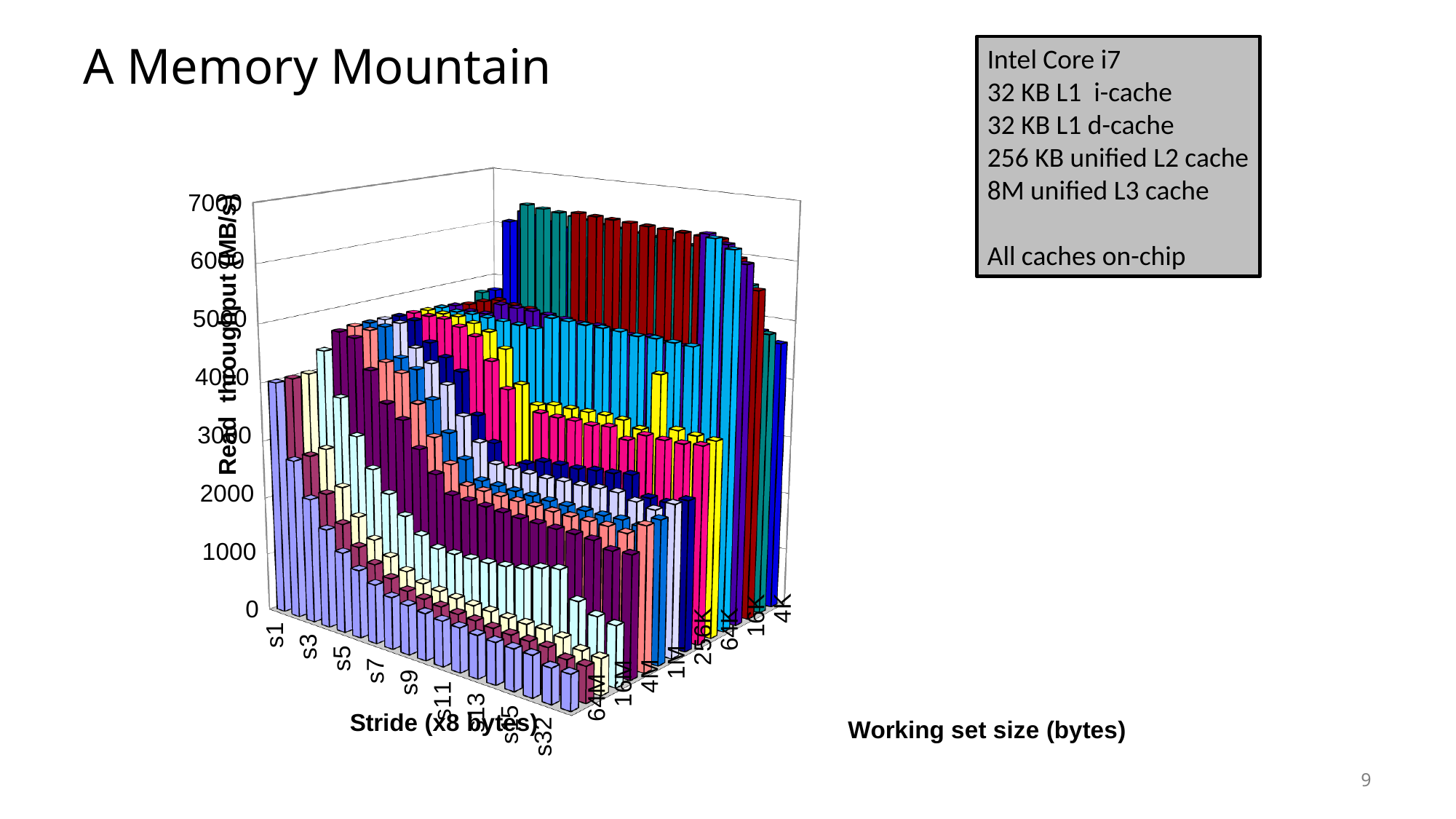
For the 64M working set size, is the read throughput at stride s32 greater or less than 2000? less What is the label of the stride axis of the chart? Stride (x8 bytes) For the 64M working set size, does read throughput rise or fall as the stride increases from s1 to s32? fall For the 64M working set size, which stride has the lowest read throughput? s32 For the 64M working set size, which stride has the highest read throughput? s1 What kind of chart is shown on the slide? bar chart For the 64M working set size, is the read throughput at stride s1 greater or less than 6000? less For the 64M working set size, which stride has the larger read throughput, s1 or s32? s1 What is the highest tick value shown on the read throughput axis? 7000 What is the label of the vertical (throughput) axis of the chart? Read throughput (MB/s) How many working set size labels are shown along the working set size axis? 8